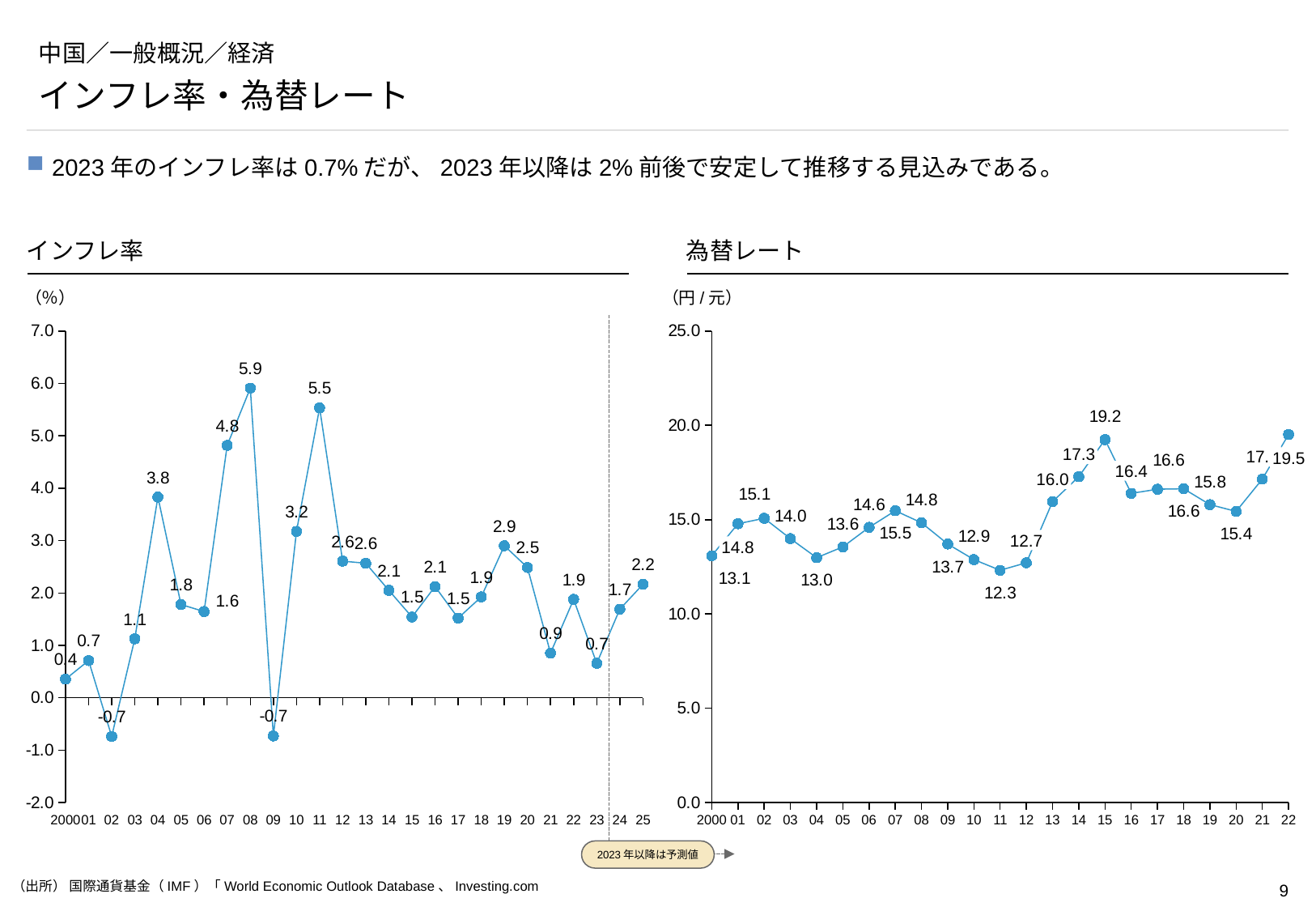
In the 為替レート chart, which year has the lowest value? 2011 In the インフレ率 chart, which is larger, the value for 2004 or the value for 2010? 2004 What kind of chart is the 為替レート chart? line chart In the 為替レート chart, do the values rise or fall from 2011 to 2015? rise In the インフレ率 chart, which year has the highest inflation rate? 2008 In the 為替レート chart, is the value for 2015 greater or less than 15.0? greater In the インフレ率 chart, what is the value for 2023? 0.7 In the インフレ率 chart, how many years are plotted? 26 In the 為替レート chart, what is the value for 2000? 13.1 In the インフレ率 chart, what is the difference between the 2008 value and the 2011 value? 0.4 In the インフレ率 chart, what is the inflation rate value for 2008? 5.9 In the 為替レート chart, which year has the highest value? 2022